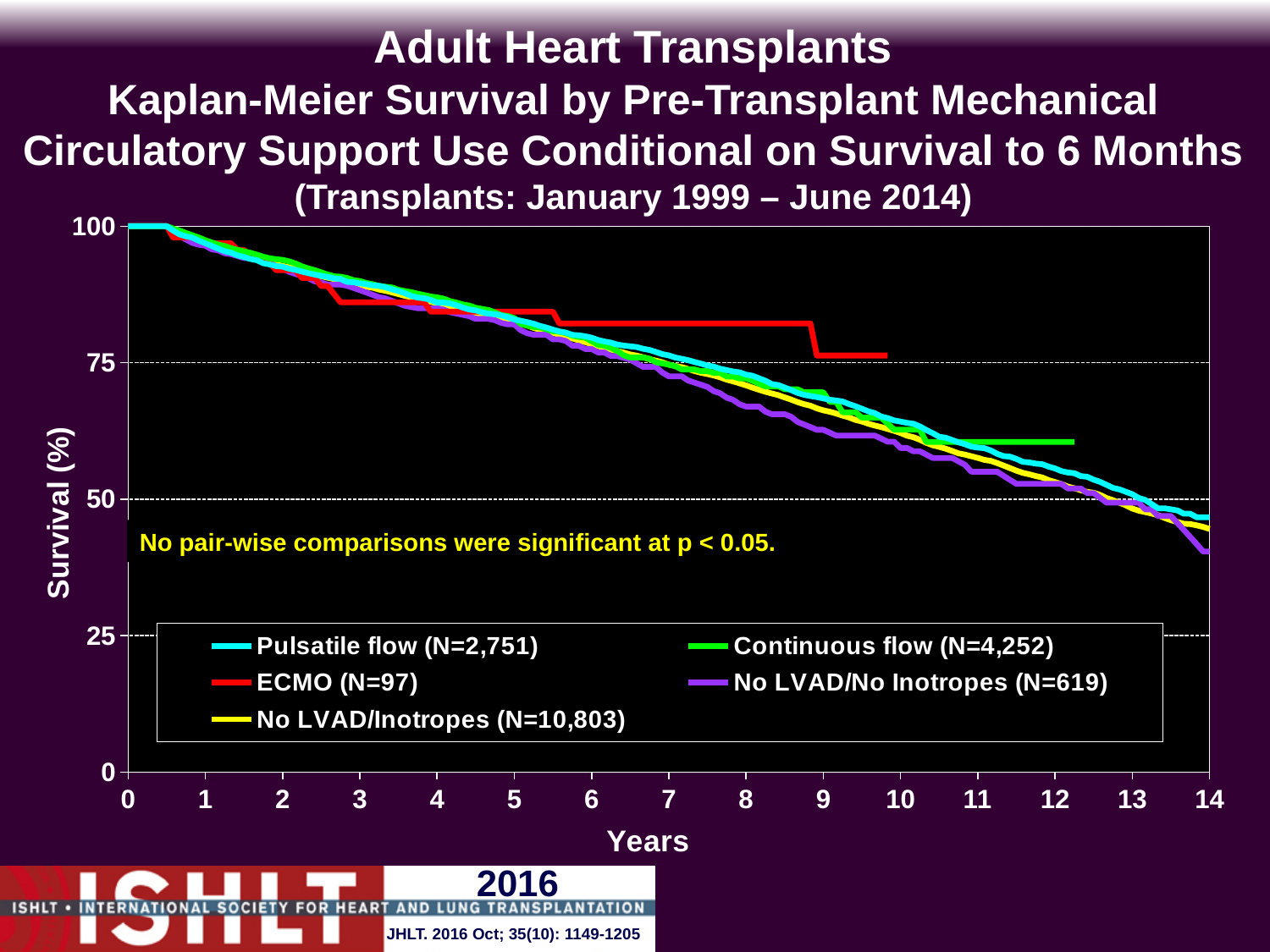
Is the survival value for ECMO at year 8 greater or less than 75? greater What kind of chart is shown on the slide? Line chart Is the survival value for Continuous flow at year 12 greater or less than 50? greater How many series does the legend list? 5 Is the survival value for Pulsatile flow at year 14 greater or less than 50? less Which group has the highest survival at year 8? ECMO Which group has the lowest survival at year 14? No LVAD/No Inotropes Which group has the largest N in the legend? No LVAD/Inotropes (N=10,803) What is the N for the ECMO group shown in the legend? 97 Do the survival curves rise or fall as years increase? Fall At year 8, which is larger: survival for ECMO or for No LVAD/No Inotropes? ECMO